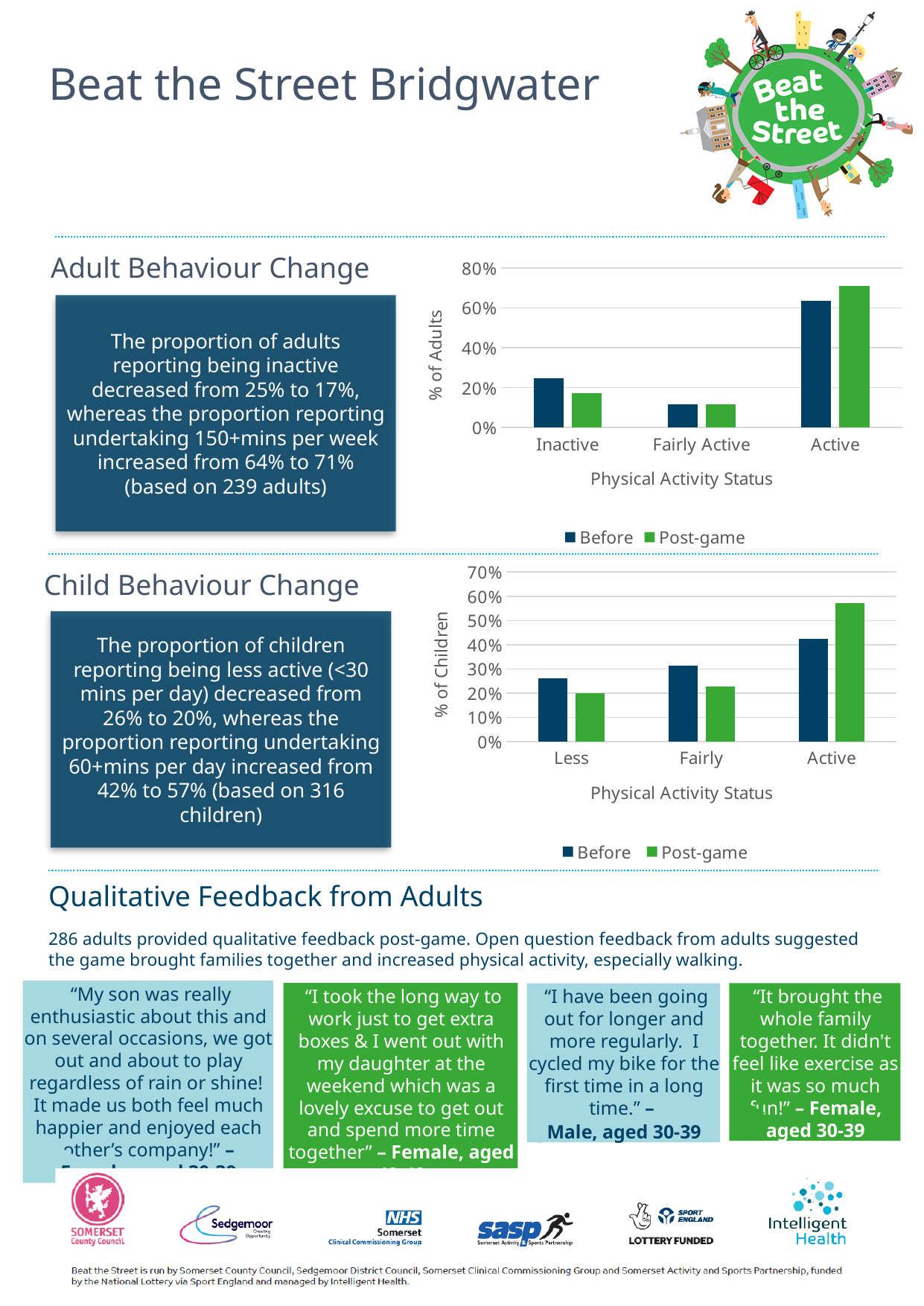
On the Adult Behaviour Change chart, is the Before value for Inactive greater or less than 20%? greater On the Adult Behaviour Change chart, how many physical activity status categories are shown on the x axis? 3 On the Adult Behaviour Change chart, which category has the highest Post-game value? Active On the Child Behaviour Change chart, is the Post-game value for Active greater or less than 50%? greater On the Adult Behaviour Change chart, how many series does the legend list? 2 On the Child Behaviour Change chart, is the Post-game value for Fairly greater or less than 30%? less On the Adult Behaviour Change chart, what kind of chart is shown? bar chart On the Child Behaviour Change chart, what is the y-axis title? % of Children On the Adult Behaviour Change chart, what is the x-axis title? Physical Activity Status On the Adult Behaviour Change chart, for Inactive, which is larger: the Before value or the Post-game value? Before On the Child Behaviour Change chart, for Active, which is larger: the Before value or the Post-game value? Post-game